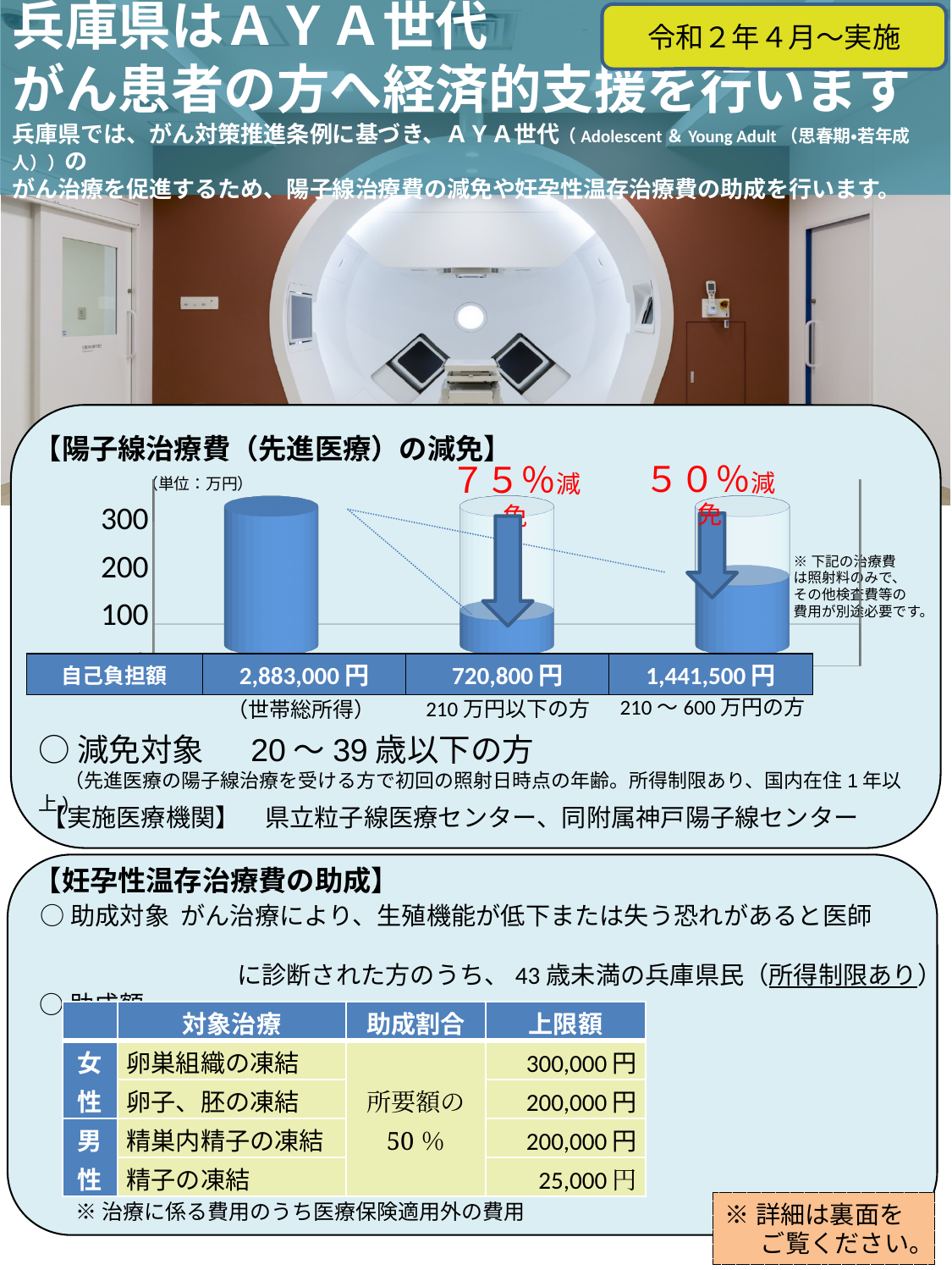
What reduction percentage is labelled above the bar for 210～600万円の方 in the 陽子線治療費 chart? 50%減免 In the 陽子線治療費 chart, is the bar for 210万円以下の方 greater or less than 100 (万円) on the axis? less What kind of chart is shown in the 【陽子線治療費（先進医療）の減免】 section? bar chart In the 陽子線治療費 chart, what is the 自己負担額 for 世帯総所得 210万円以下の方? 720,800円 In the 陽子線治療費 chart, what is the difference between the 自己負担額 for 210～600万円の方 and for 210万円以下の方? 720,700円 In the 陽子線治療費 chart, what is the 自己負担額 for 世帯総所得 210～600万円の方? 1,441,500円 In the 陽子線治療費 chart, is the 自己負担額 for 210～600万円の方 larger or smaller than that for 210万円以下の方? larger In the 陽子線治療費 chart, which bar has the lowest 自己負担額? 210万円以下の方 (720,800円) In the 陽子線治療費 chart, what is the difference between the full 自己負担額 and the amount for 210万円以下の方? 2,162,200円 How many bars are plotted in the 陽子線治療費 chart? 3 In the 陽子線治療費 chart, which bar has the highest 自己負担額? the full amount bar (2,883,000円) In the 陽子線治療費 chart, what is the 自己負担額 for the full (unreduced) amount shown by the first bar? 2,883,000円